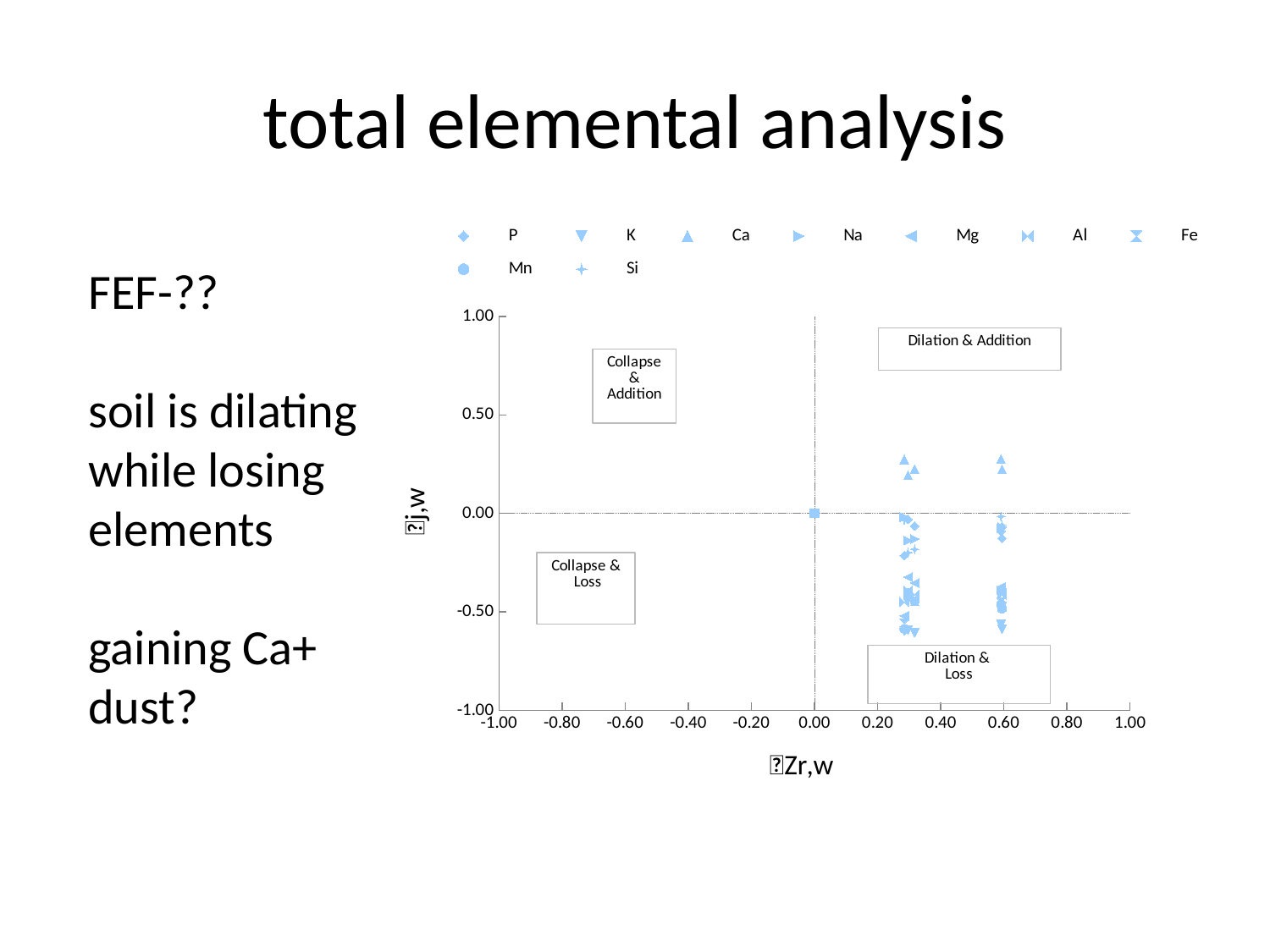
Which series has its points plotted above the 0.00 line on the y axis? Ca Which elements are listed in the chart's legend? P, K, Ca, Na, Mg, Al, Fe, Mn, Si Which quadrant label is shown in the upper-left region of the chart? Collapse & Addition Are the y values of the Fe points greater or less than 0.00? less What is the highest value shown on the chart's y axis? 1.00 Which quadrant label is shown in the lower-right region of the chart? Dilation & Loss Are the x values of the plotted data points greater or less than 0.00? greater Are the y values of the Ca points greater or less than 0.00? greater How many series does the chart's legend list? 9 What kind of chart is shown on the slide? scatter chart In which labelled quadrant do most of the plotted points fall? Dilation & Loss